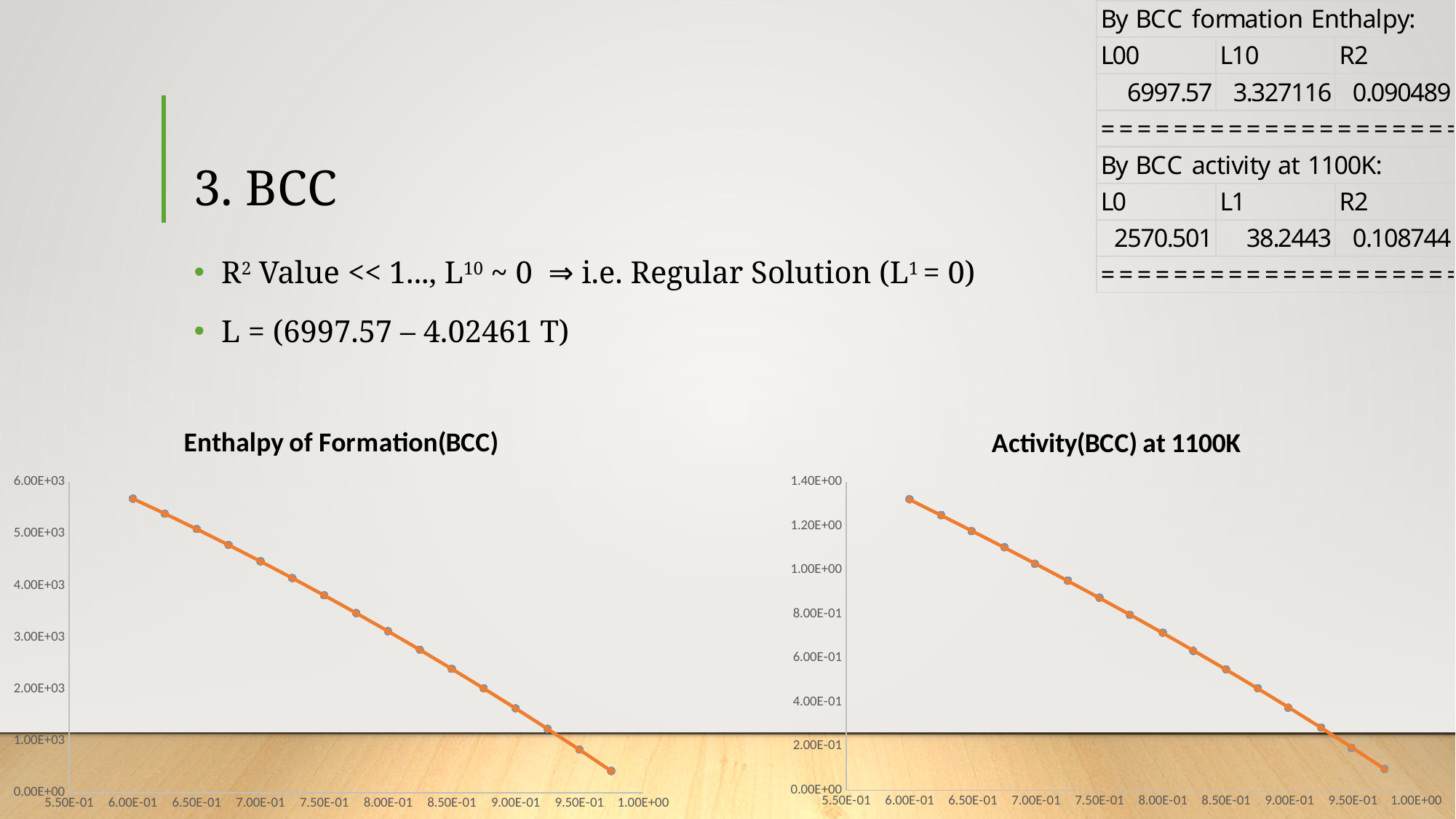
In the 'Activity(BCC) at 1100K' chart, is the value at x = 9.50E-01 greater or less than 4.00E-01? less In the 'Activity(BCC) at 1100K' chart, is the value at x = 7.50E-01 greater or less than 1.00E+00? less What is the highest value shown on the y axis of the 'Activity(BCC) at 1100K' chart? 1.40E+00 In the 'Activity(BCC) at 1100K' chart, is the value at x = 6.00E-01 greater or less than 1.20E+00? greater In the 'Activity(BCC) at 1100K' chart, do the values rise or fall as the x value increases? fall What type of chart is the 'Enthalpy of Formation(BCC)' chart? scatter chart with a trend line In the 'Enthalpy of Formation(BCC)' chart, do the values rise or fall as the x value increases? fall How many data points are plotted in the 'Activity(BCC) at 1100K' chart? 16 What is the title of the chart on the right side of the slide? Activity(BCC) at 1100K